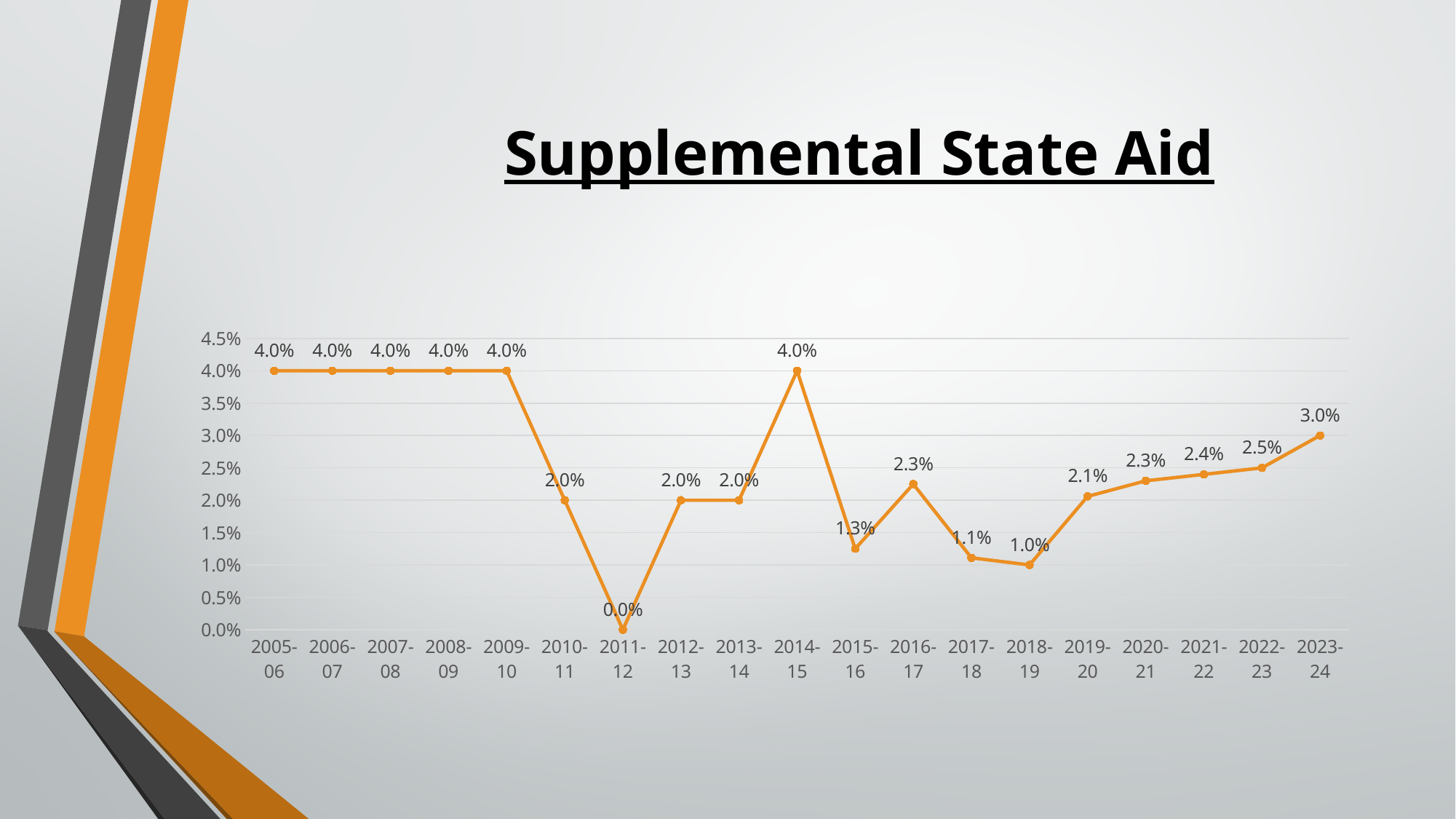
How many data points are plotted on the chart? 19 What kind of chart is shown? Line chart What is the value for 2015-16? 1.3% Do the values rise or fall from 2018-19 to 2023-24? Rise What is the value for 2011-12? 0.0% Which is larger, the value for 2016-17 or the value for 2017-18? 2016-17 What is the difference between the values for 2014-15 and 2015-16? 2.7% What is the difference between the values for 2023-24 and 2018-19? 2.0% What is the value for 2018-19? 1.0% Which year has the lowest value? 2011-12 What is the title of the chart? Supplemental State Aid What is the value for 2023-24? 3.0%